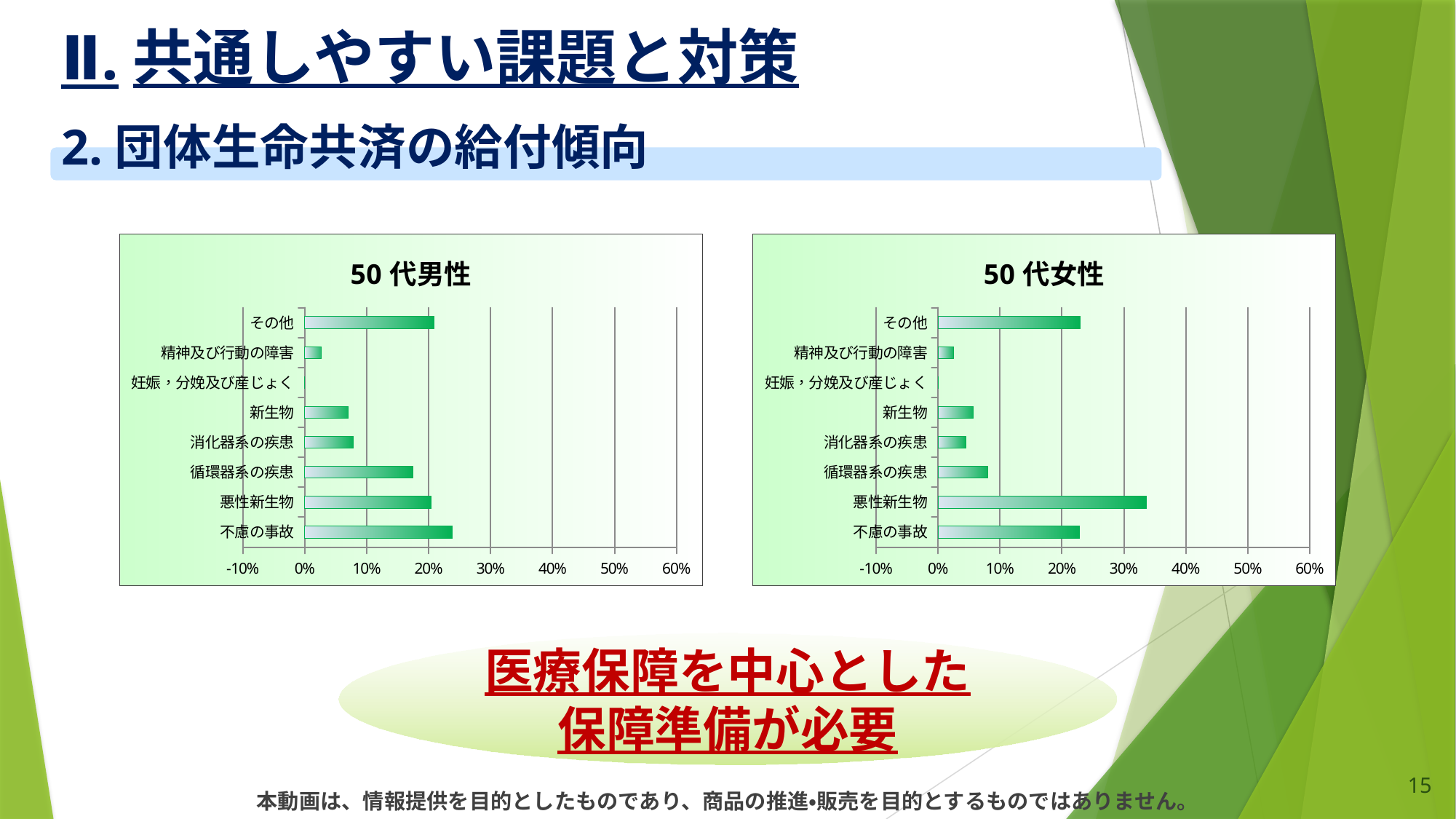
In the 50 代男性 chart, which category has the highest value? 不慮の事故 In the 50 代男性 chart, is the value for 不慮の事故 greater or less than 20%? greater How many categories are listed on the 50 代女性 chart? 8 In the 50 代男性 chart, which is larger: 循環器系の疾患 or 消化器系の疾患? 循環器系の疾患 In the 50 代男性 chart, is the value for 循環器系の疾患 greater or less than 20%? less In the 50 代女性 chart, is the value for 悪性新生物 greater or less than 30%? greater What is the title of the chart on the right side of the slide? 50 代女性 In the 50 代女性 chart, which is larger: 悪性新生物 or その他? 悪性新生物 What kind of chart is the 50 代男性 chart? bar chart In the 50 代女性 chart, which category has the highest value? 悪性新生物 In the 50 代男性 chart, which category shows no bar at all? 妊娠，分娩及び産じょく